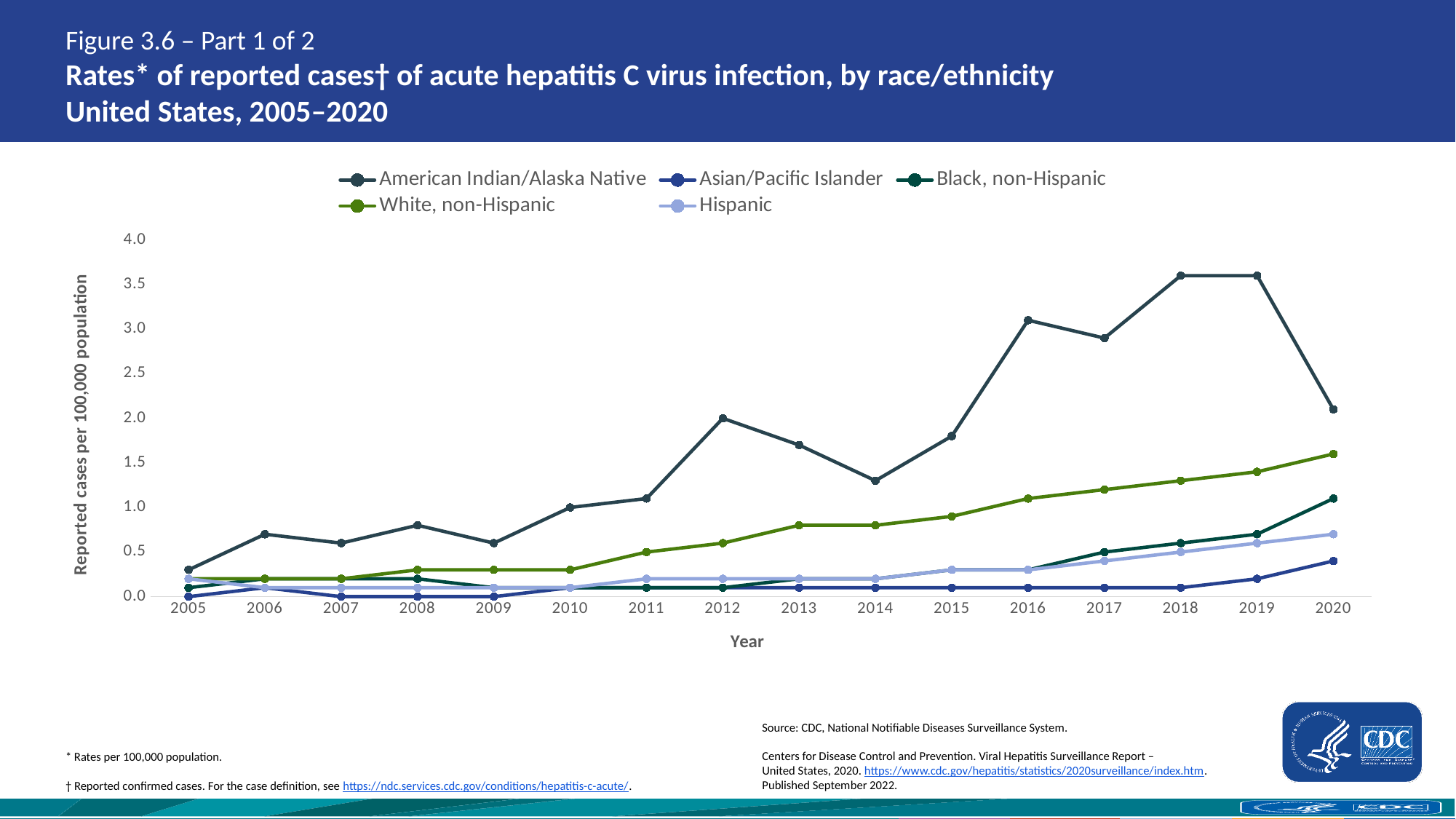
For American Indian/Alaska Native, which year has the larger rate: 2019 or 2020? 2019 Is the value for Hispanic in 2020 greater or less than 1.0? less What kind of chart is shown on the slide? line chart Which race/ethnicity group has the lowest rate in 2020? Asian/Pacific Islander Does the rate for White, non-Hispanic generally rise or fall from 2005 to 2020? rise Is the value for American Indian/Alaska Native in 2014 greater or less than 1.5? less Which race/ethnicity group has the highest rate in 2018? American Indian/Alaska Native In 2020, which is larger: the rate for Black, non-Hispanic or the rate for Asian/Pacific Islander? Black, non-Hispanic Is the value for American Indian/Alaska Native in 2018 greater or less than 3.0? greater How many years are plotted along the x axis? 16 How many series does the legend list? 5